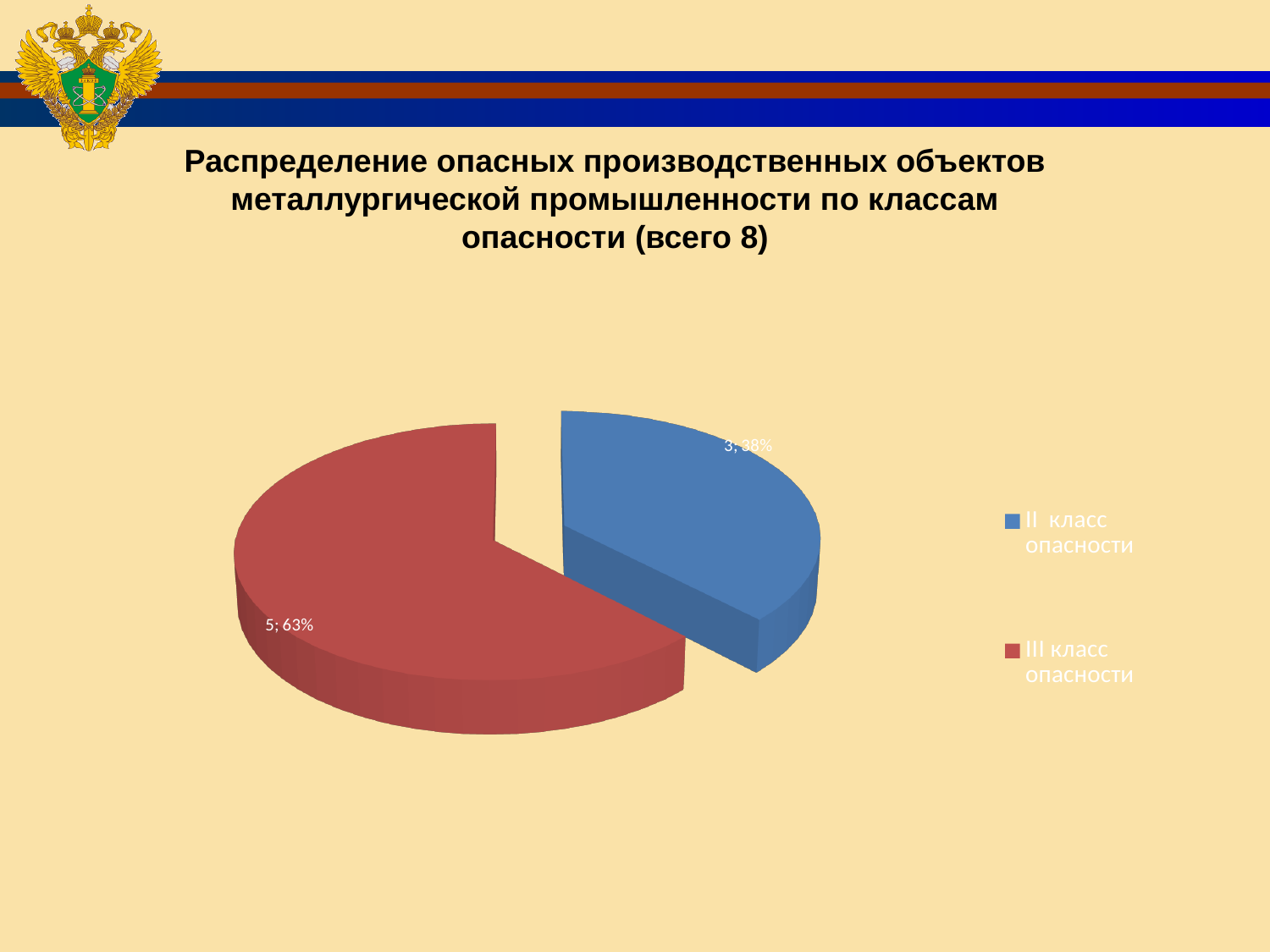
What share of the pie does III класс опасности take? 63% What is the number of objects for II класс опасности? 3 What colour is the slice for III класс опасности? Red Which is larger: the value for II класс опасности or III класс опасности? III класс опасности What kind of chart is shown on the slide? Pie chart What share of the pie does II класс опасности take? 38% How many slices does the pie chart have? 2 What is the difference between the number of objects for III класс опасности and II класс опасности? 2 How many entries does the legend list? 2 Which hazard class has the smallest slice of the pie? II класс опасности Which hazard class has the largest slice of the pie? III класс опасности What is the number of objects for III класс опасности? 5